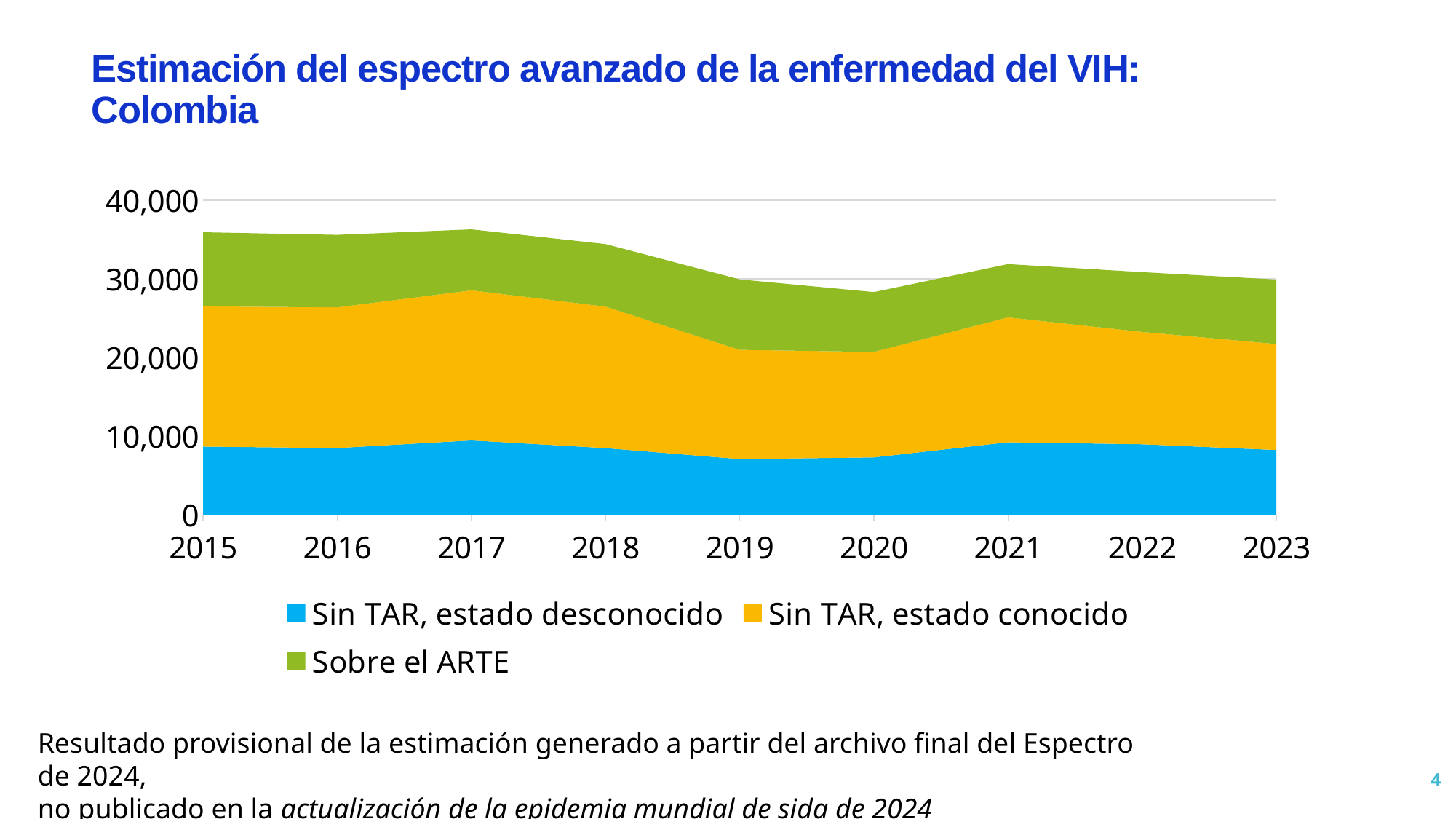
Which year has the lowest total stacked value? 2020 What kind of chart is shown on the slide? Stacked area chart Is the total stacked value for 2017 greater or less than 30,000? greater How many series does the legend list? 3 Is the total stacked value larger in 2015 or in 2020? 2015 Which series is shown in green? Sobre el ARTE Is the total stacked value for 2015 greater or less than 30,000? greater How many years are plotted along the x axis? 9 Is the total stacked value for 2020 greater or less than 30,000? less What is the title of the chart? Estimación del espectro avanzado de la enfermedad del VIH: Colombia Does the total stacked value rise or fall from 2015 to 2020? fall